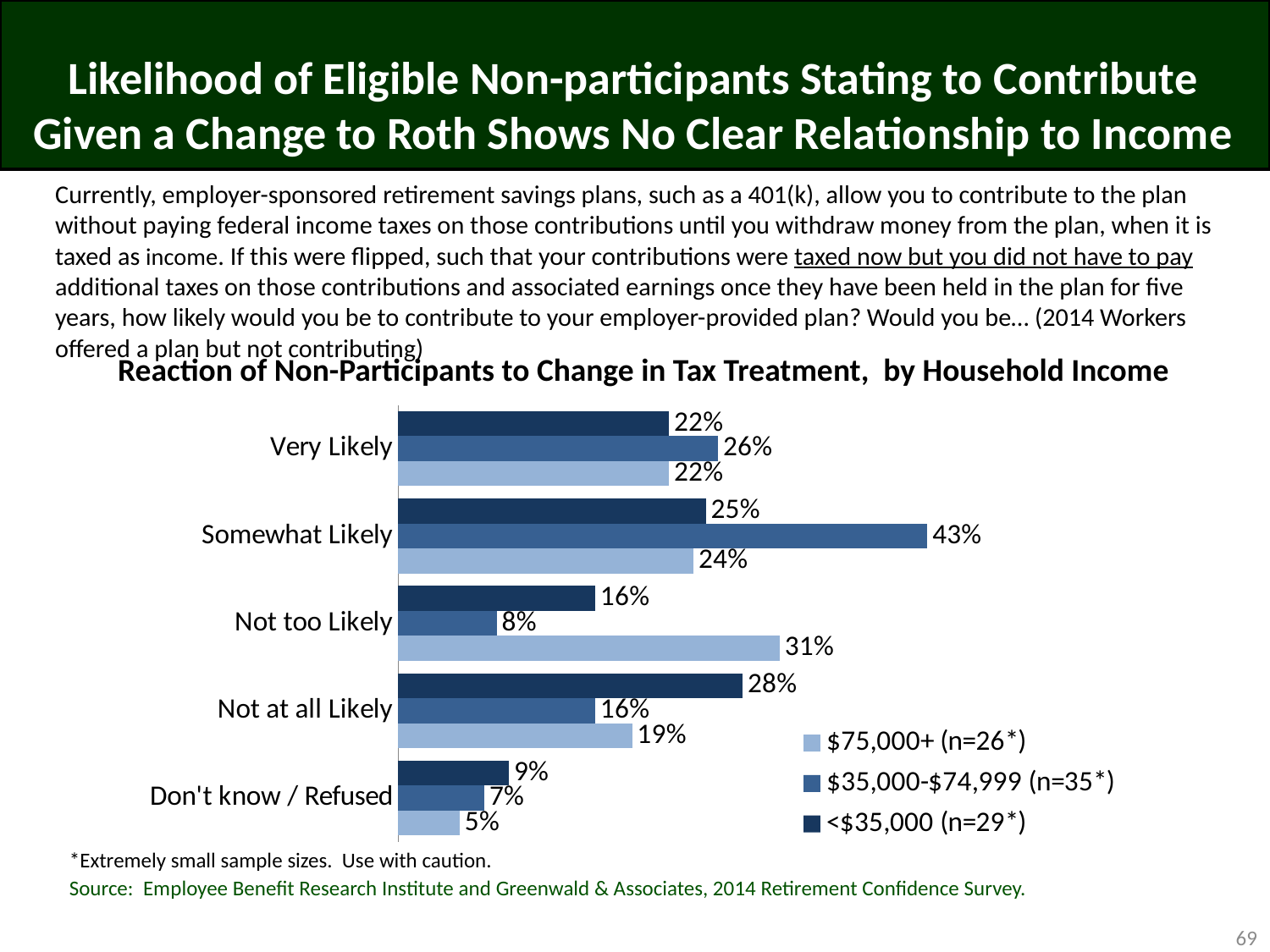
How many income groups does the legend list? 3 Which income group has the highest value in the Somewhat Likely category? $35,000-$74,999 What is the difference between the $75,000+ and <$35,000 values in the Not too Likely category? 15 percentage points Which is larger: the <$35,000 value for Not at all Likely or the $35,000-$74,999 value for Not at all Likely? <$35,000 What is the value for the $75,000+ group in the Don't know / Refused category? 5% What percentage of the $35,000-$74,999 group said they would be Somewhat Likely to contribute? 43% How many response categories are shown on the chart? 5 What is the value for the $75,000+ group in the Not too Likely category? 31% What is the sample size shown in the legend for the $35,000-$74,999 group? n=35* Which income group has the lowest value in the Not too Likely category? $35,000-$74,999 What percentage of the <$35,000 group answered Not at all Likely? 28% What type of chart is shown on the slide? Bar chart